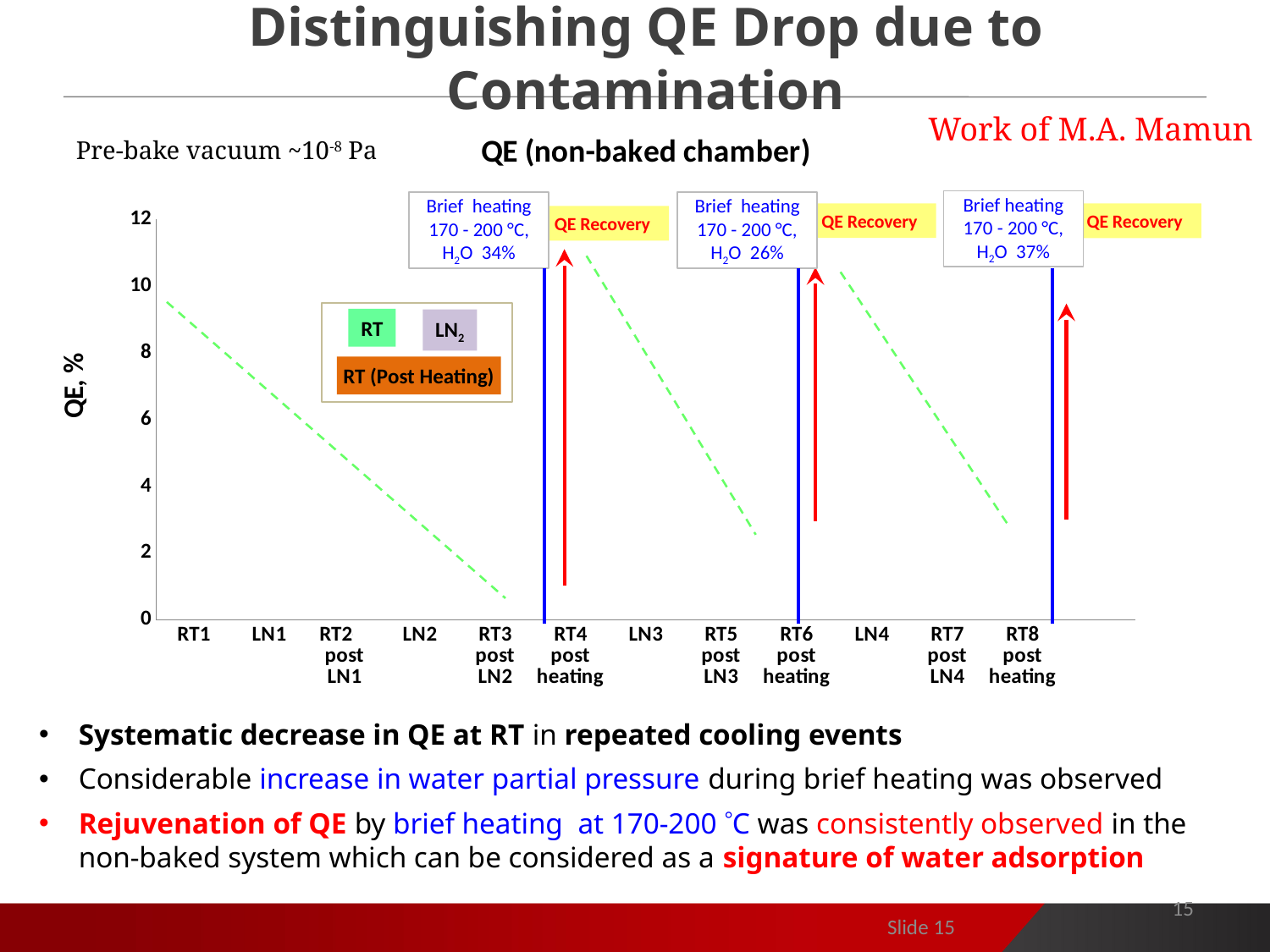
What H2O percentage is noted for the first brief heating annotation? 34% What is the title of the chart? QE (non-baked chamber) Is the QE value at RT4 post heating greater or less than 8? greater Which brief heating annotation shows the lowest H2O percentage? the second (26%) Is the QE value at RT3 post LN2 greater or less than 2? less Does the QE value rise or fall from RT1 to RT3 post LN2? fall What is the label of the y axis of the chart? QE, % What type of chart is shown on the slide? line chart How many entries does the chart's legend list? 3 What H2O percentage is noted for the third brief heating annotation? 37% How many categories are labelled along the x axis of the chart? 12 Is the QE value at RT1 greater or less than 8? greater